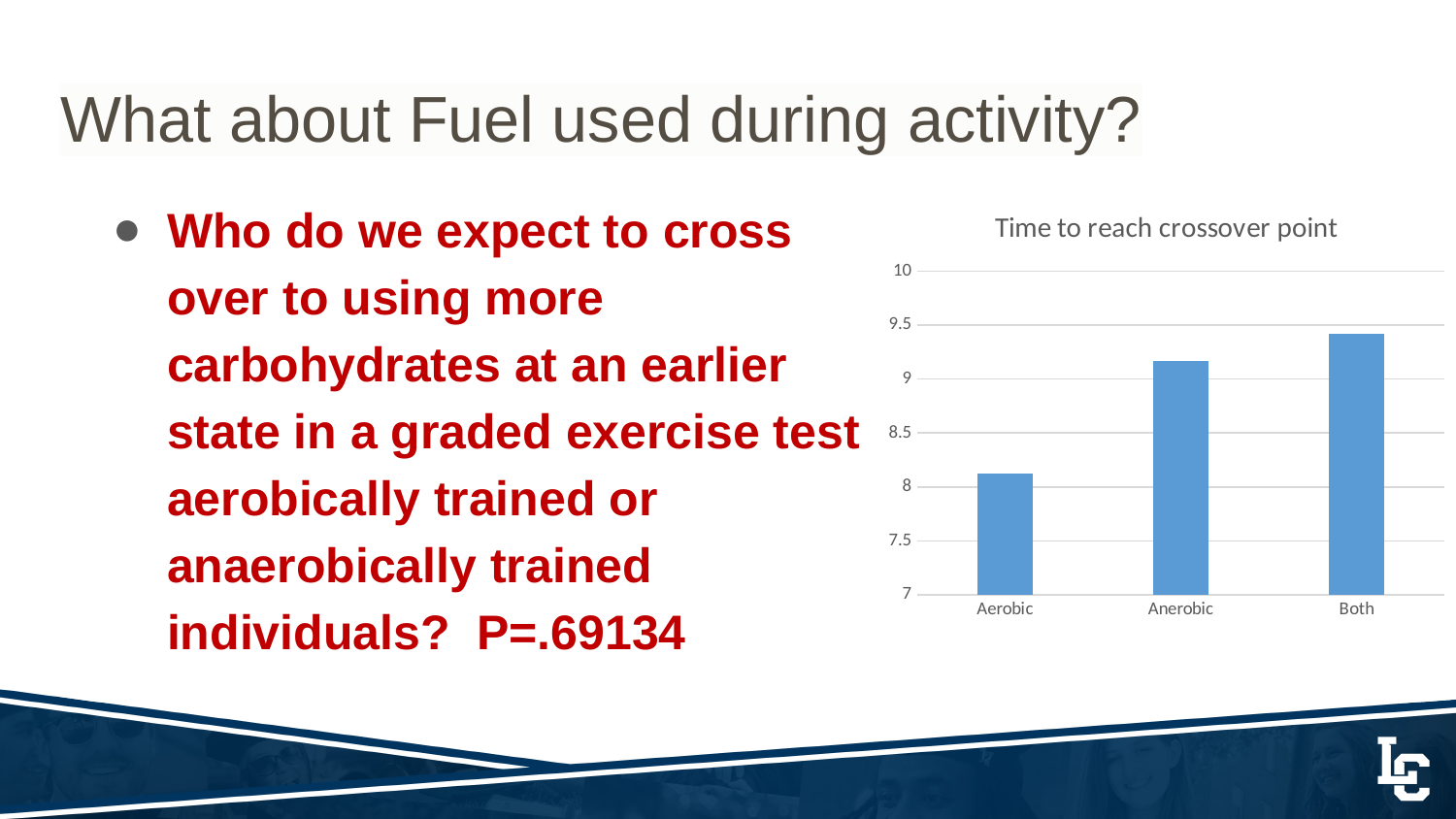
Is the value for Anerobic greater or less than 9? greater How many categories are shown on the x axis of the chart? 3 What is the title of the chart? Time to reach crossover point Do the bar values rise or fall from left to right across the categories? rise What kind of chart is shown on the slide? bar chart Which category has the highest time to reach crossover point? Both Is the value for Both greater or less than 9.5? less Which is larger, the value for Aerobic or the value for Anerobic? Anerobic Which category has the lowest time to reach crossover point? Aerobic Which is larger, the value for Aerobic or the value for Both? Both Is the value for Aerobic greater or less than 8.5? less